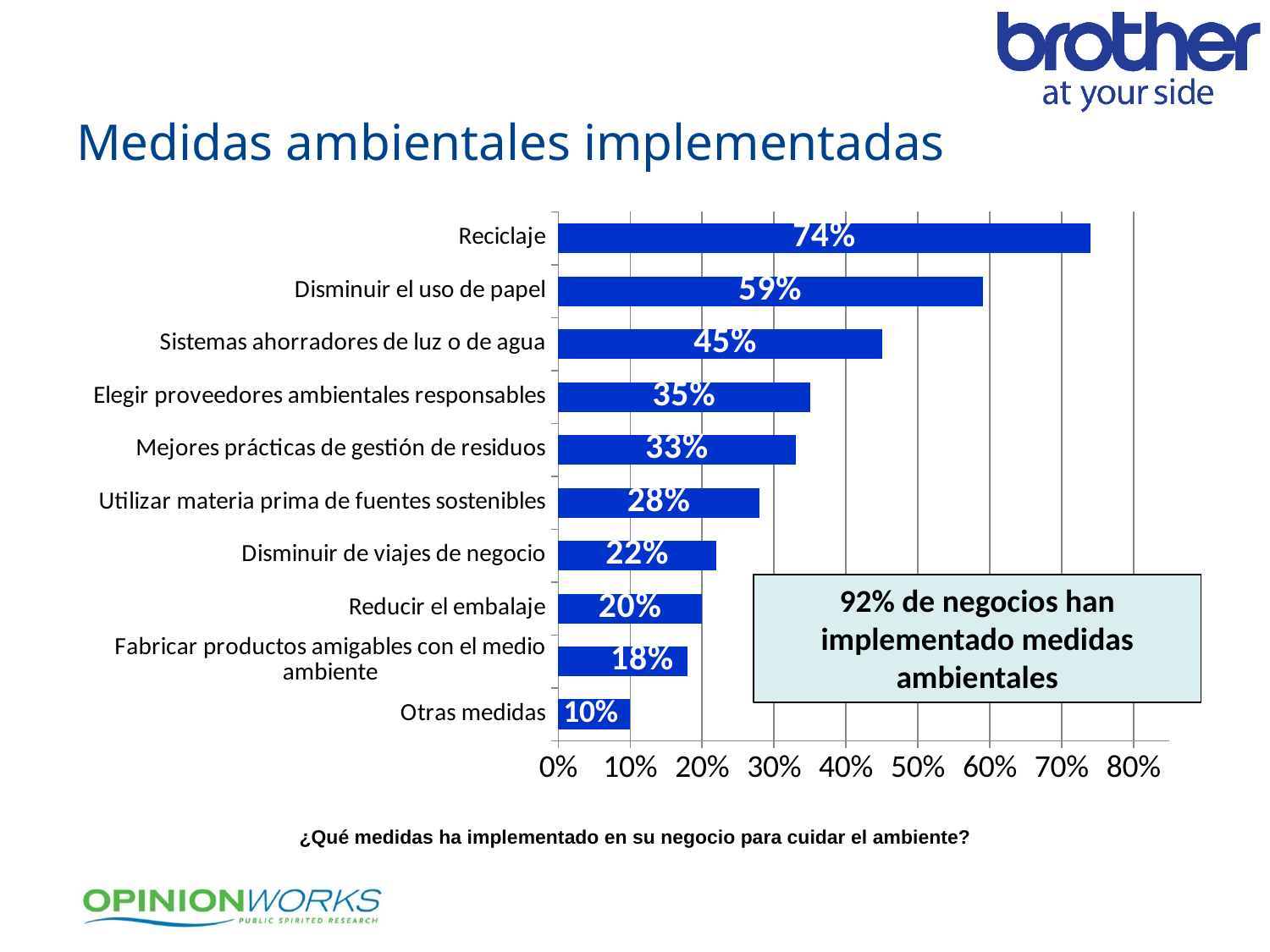
What is the difference between the values for Reciclaje and Disminuir el uso de papel? 15% What kind of chart is shown on the slide? bar chart What is the value for Reducir el embalaje? 20% What is the difference between the values for Sistemas ahorradores de luz o de agua and Otras medidas? 35% Is the value for Mejores prácticas de gestión de residuos greater or less than 40%? less What is the value for Disminuir el uso de papel? 59% What is the value for Reciclaje? 74% How many categories are shown in the chart? 10 What is the title of the slide? Medidas ambientales implementadas Which category has the lowest value? Otras medidas Which category has the highest value? Reciclaje Which is larger, the value for Elegir proveedores ambientales responsables or the value for Utilizar materia prima de fuentes sostenibles? Elegir proveedores ambientales responsables